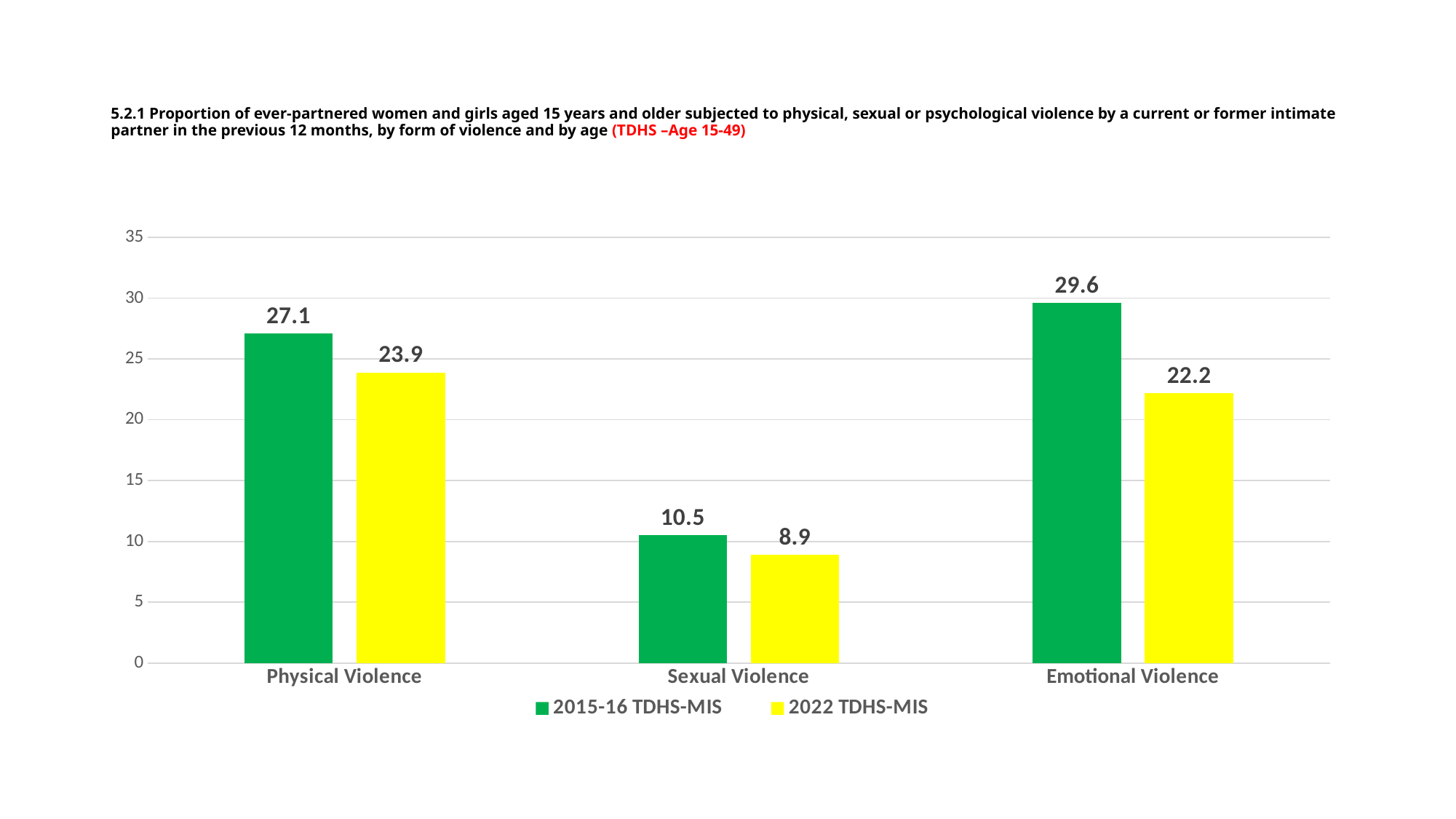
Which is larger for Sexual Violence: the 2015-16 TDHS-MIS value or the 2022 TDHS-MIS value? 2015-16 TDHS-MIS Which form of violence has the highest value in the 2015-16 TDHS-MIS series? Emotional Violence What is the difference between the 2015-16 TDHS-MIS and 2022 TDHS-MIS values for Emotional Violence? 7.4 What is the value for Sexual Violence in the 2022 TDHS-MIS series? 8.9 What is the value for Physical Violence in the 2015-16 TDHS-MIS series? 27.1 How many forms of violence are shown on the x axis? 3 What is the difference between the 2015-16 TDHS-MIS and 2022 TDHS-MIS values for Physical Violence? 3.2 Is the 2022 TDHS-MIS value for Physical Violence greater or less than 25? less What kind of chart is shown on the slide? bar chart Which form of violence has the lowest value in the 2022 TDHS-MIS series? Sexual Violence How many series does the legend list? 2 What is the value for Emotional Violence in the 2022 TDHS-MIS series? 22.2